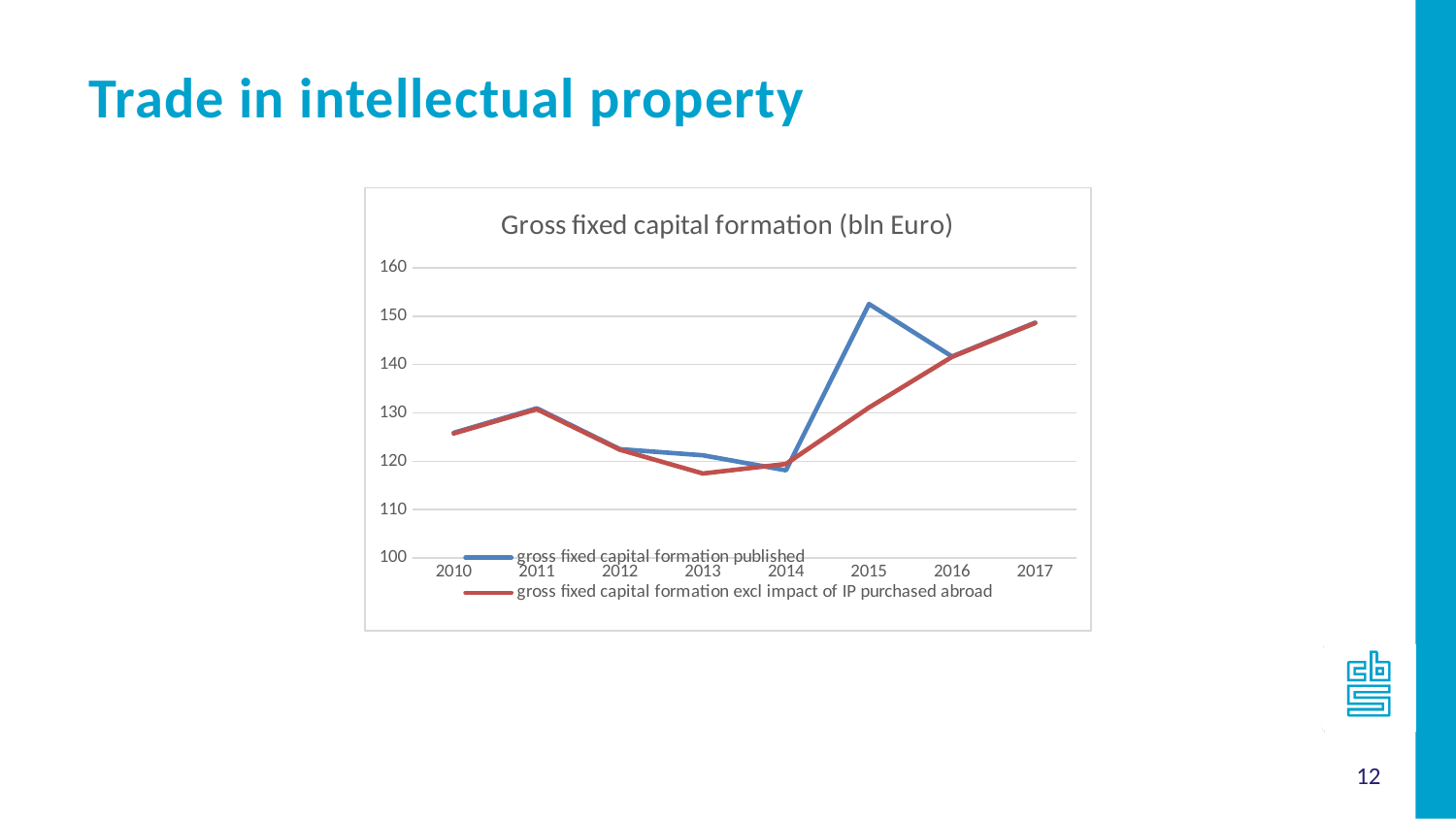
What kind of chart is shown on the slide? line chart Is the value for 'gross fixed capital formation published' in 2015 greater or less than 150? greater Does the 'gross fixed capital formation excl impact of IP purchased abroad' series rise or fall from 2014 to 2017? rise In 2015, which series has the larger value: 'gross fixed capital formation published' or 'gross fixed capital formation excl impact of IP purchased abroad'? gross fixed capital formation published What is the title of the chart? Gross fixed capital formation (bln Euro) How many series does the legend list? 2 Is the value for 'gross fixed capital formation excl impact of IP purchased abroad' in 2013 greater or less than 120? less In which year does the 'gross fixed capital formation excl impact of IP purchased abroad' series reach its lowest value? 2013 Which colour is used for the 'gross fixed capital formation published' series? blue In which year does the 'gross fixed capital formation published' series reach its highest value? 2015 How many years are shown on the x axis? 8